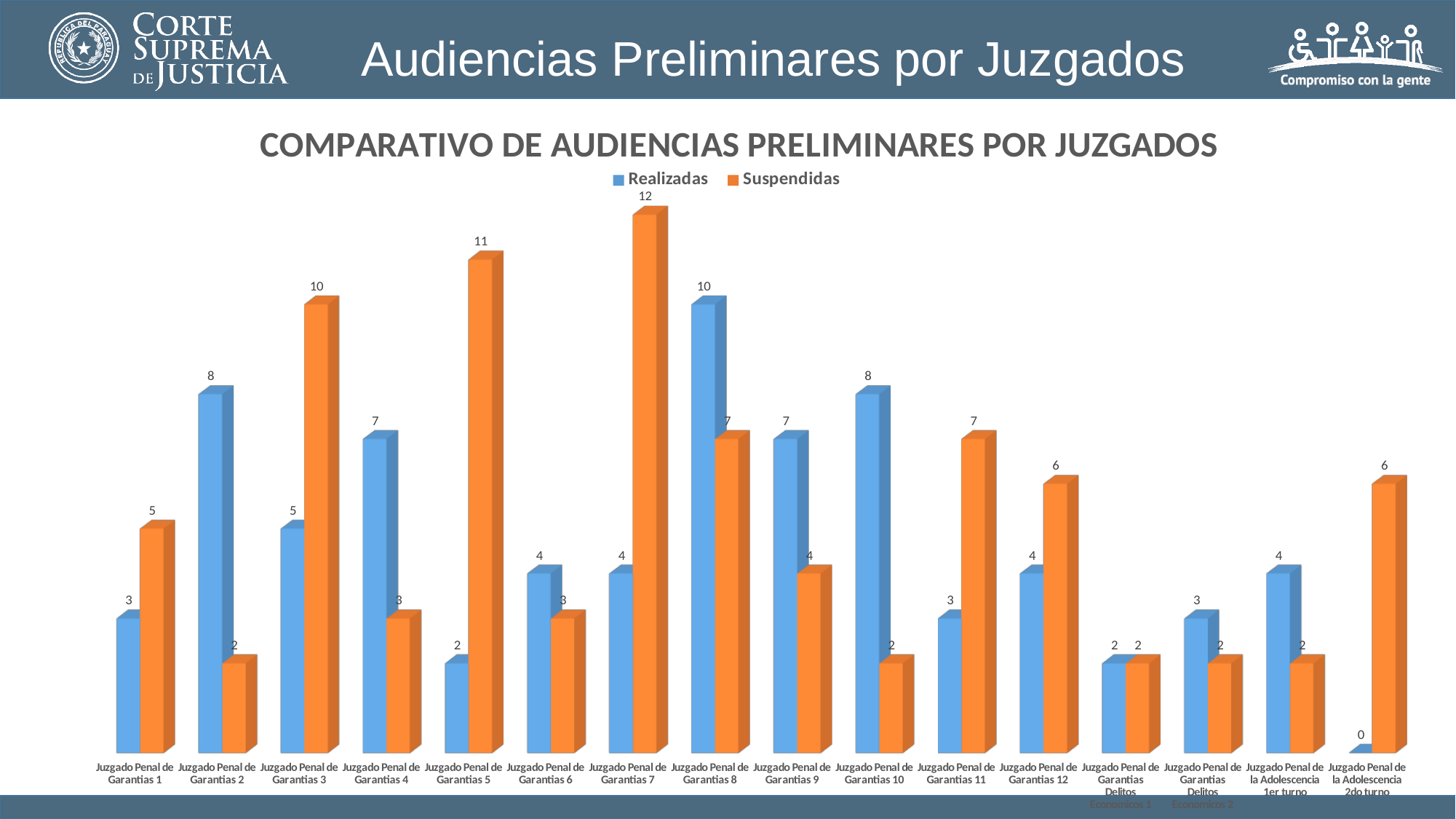
How many categories are shown on the x axis? 16 What is the Realizadas value for Juzgado Penal de Garantias 8? 10 What is the difference between Suspendidas and Realizadas for Juzgado Penal de Garantias 3? 5 What is the Realizadas value for Juzgado Penal de la Adolescencia 2do turno? 0 Which category has the highest Suspendidas value? Juzgado Penal de Garantias 7 How many series does the legend list? 2 Which category has the highest Realizadas value? Juzgado Penal de Garantias 8 What is the title of the chart? COMPARATIVO DE AUDIENCIAS PRELIMINARES POR JUZGADOS What is the Suspendidas value for Juzgado Penal de Garantias 5? 11 What kind of chart is shown on the slide? bar chart Which category has the lowest Realizadas value? Juzgado Penal de la Adolescencia 2do turno For Juzgado Penal de Garantias 10, which is larger, Realizadas or Suspendidas? Realizadas